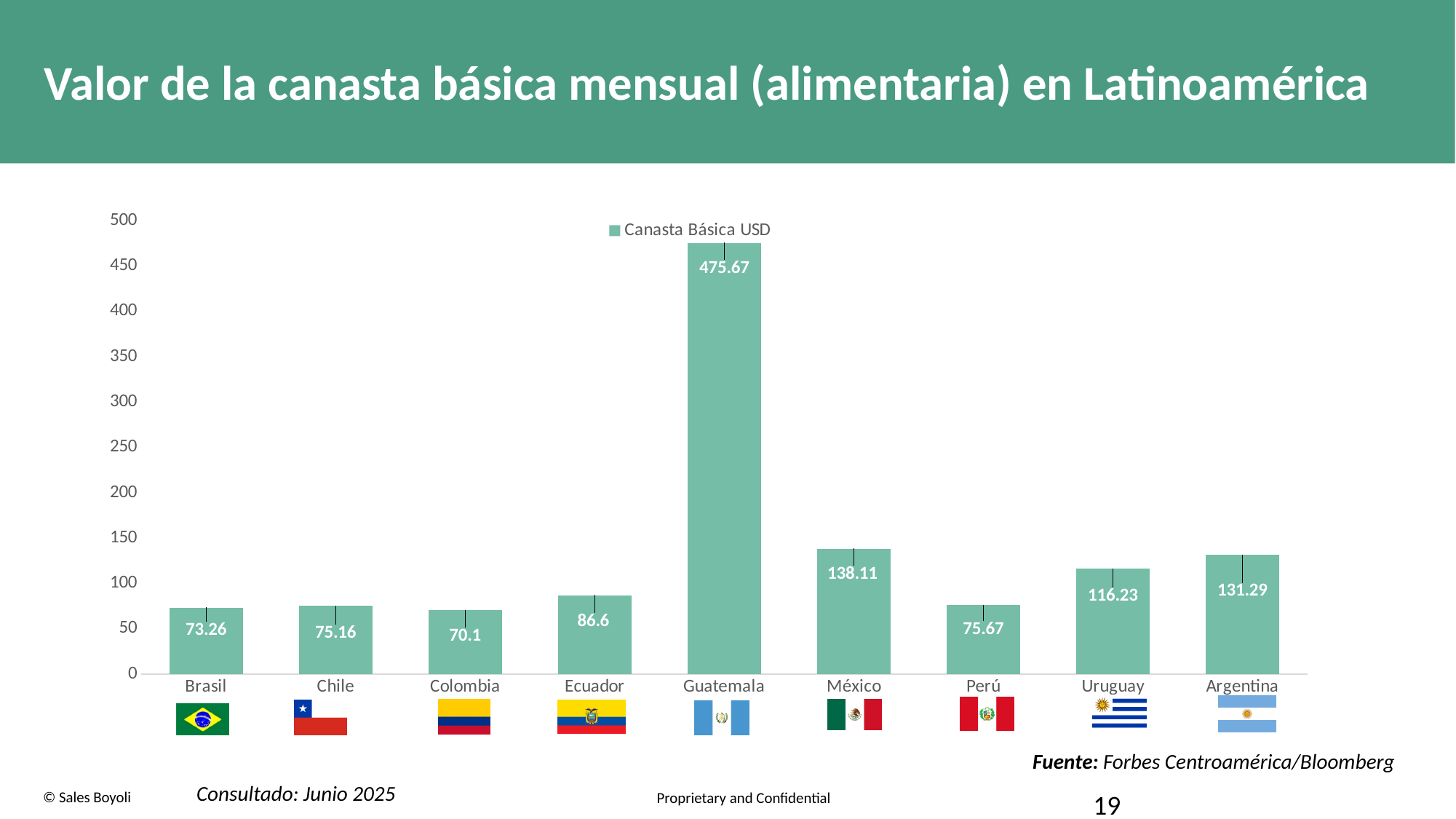
How many countries are shown on the x axis? 9 What is the value for Colombia? 70.1 What kind of chart is shown? bar chart How many series does the legend list? 1 What is the value for Uruguay? 116.23 Which country has the highest value? Guatemala What is the value for Guatemala? 475.67 Is the value for Ecuador greater or less than 100? less Which country has the lowest value? Colombia Which is larger, the value for Argentina or the value for Uruguay? Argentina What is the legend entry for the series? Canasta Básica USD What is the difference between the values for México and Perú? 62.44